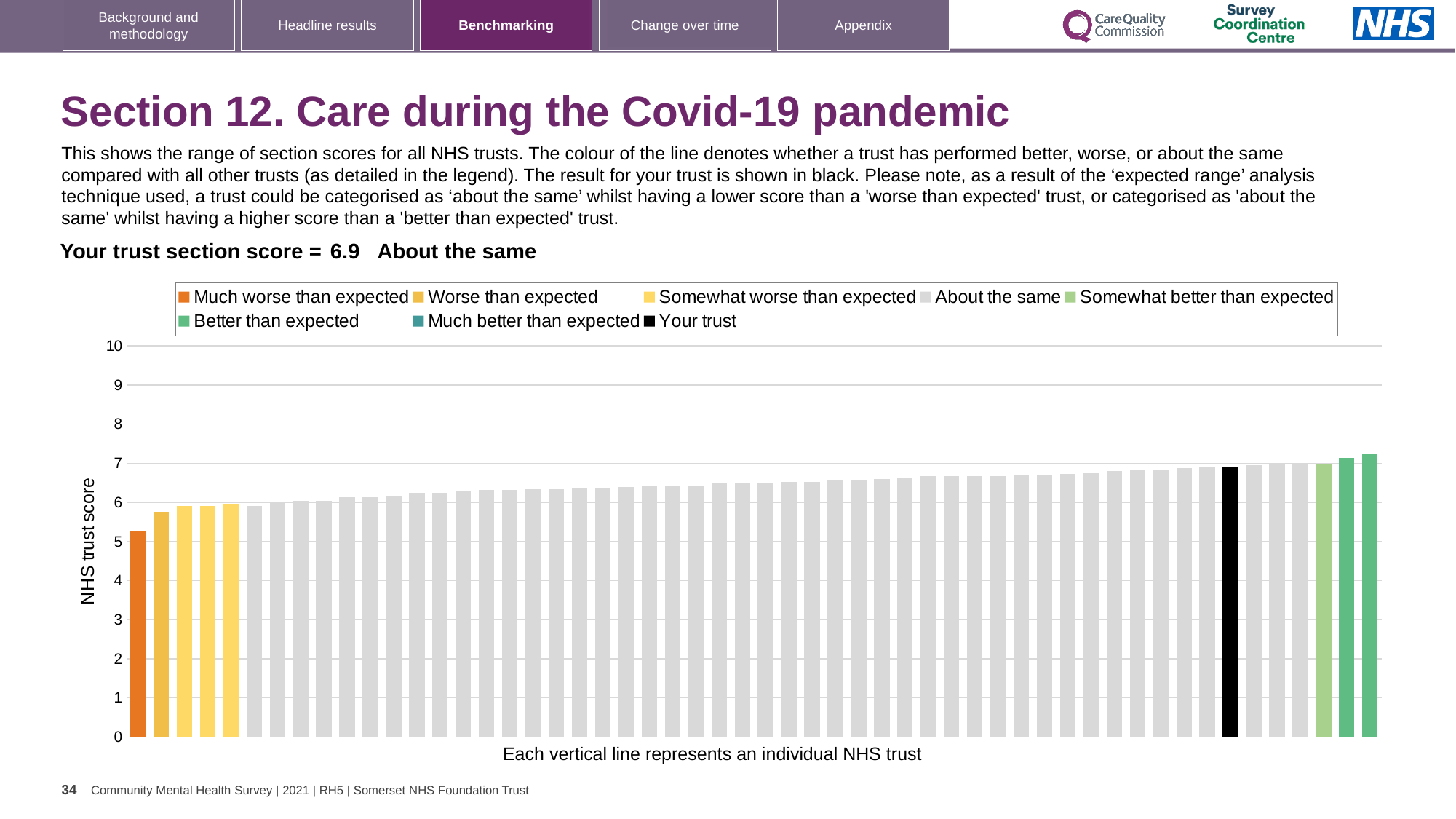
What kind of chart is shown on the slide? bar chart What colour is the bar representing your trust? black Which is larger: the orange 'Much worse than expected' bar or the black 'Your trust' bar? Your trust Is the value of the tallest bar greater or less than 8? less Which legend category does the lowest bar in the chart belong to? Much worse than expected What is the label on the vertical axis of the chart? NHS trust score What is the section score for your trust shown on the slide? 6.9 Which category is your trust placed in for this section? About the same Is the value of the lowest (orange) bar greater or less than 6? less Is the value of the black 'Your trust' bar greater or less than 5? greater Do the bar values rise or fall from left to right along the x axis? rise How many entries does the chart legend list? 8